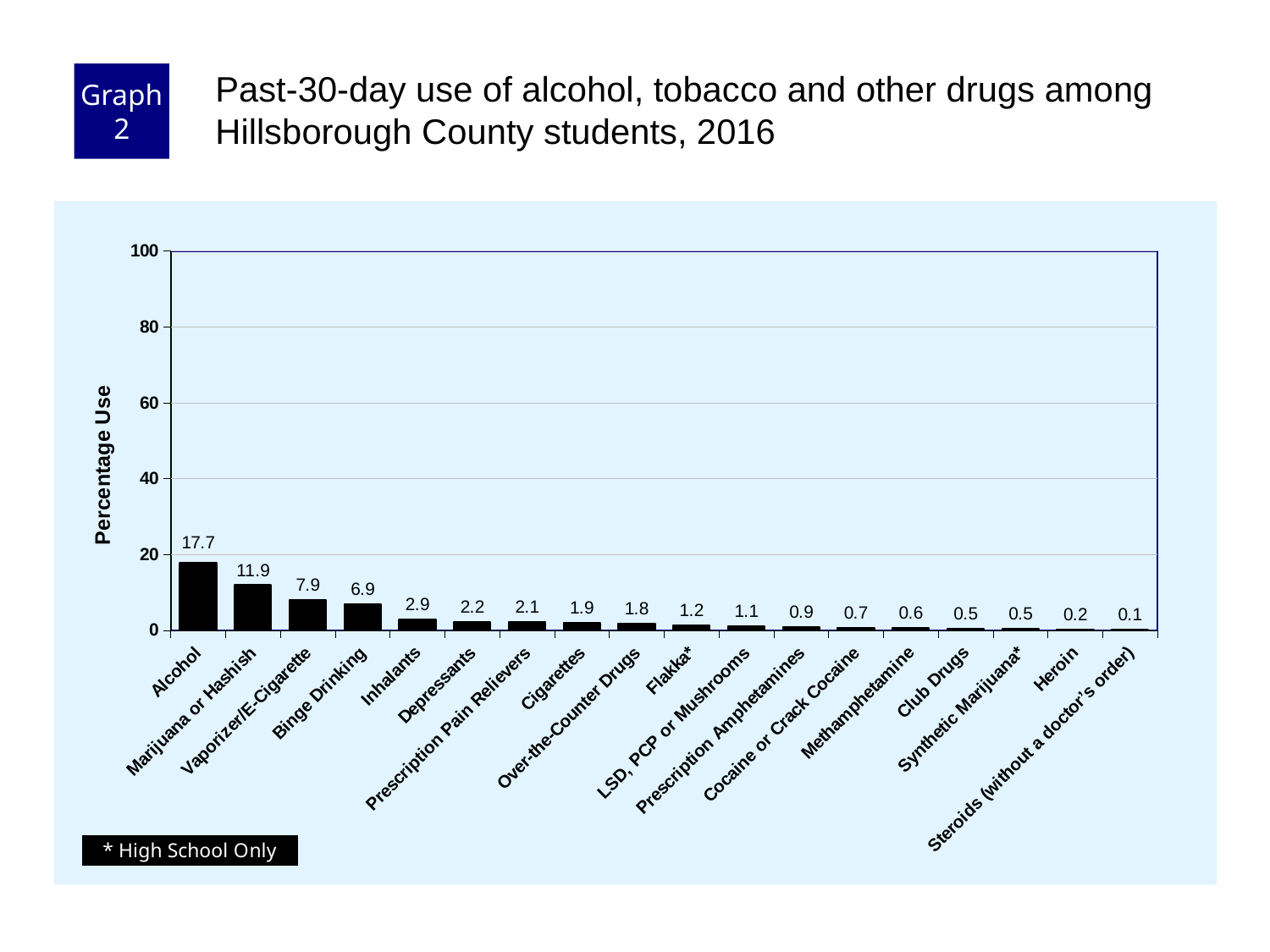
How many categories are shown on the x axis? 18 What is the percentage use for Heroin? 0.2 What is the label of the y axis? Percentage Use Is the value for Marijuana or Hashish greater or less than 20? less What is the percentage use for Vaporizer/E-Cigarette? 7.9 What is the difference in percentage use between Alcohol and Marijuana or Hashish? 5.8 What is the percentage use for Cigarettes? 1.9 Which category has the lowest percentage use? Steroids (without a doctor's order) Which has a higher percentage use, Binge Drinking or Inhalants? Binge Drinking What kind of chart is shown on the slide? bar chart What is the percentage use for Alcohol? 17.7 Which category has the highest percentage use? Alcohol